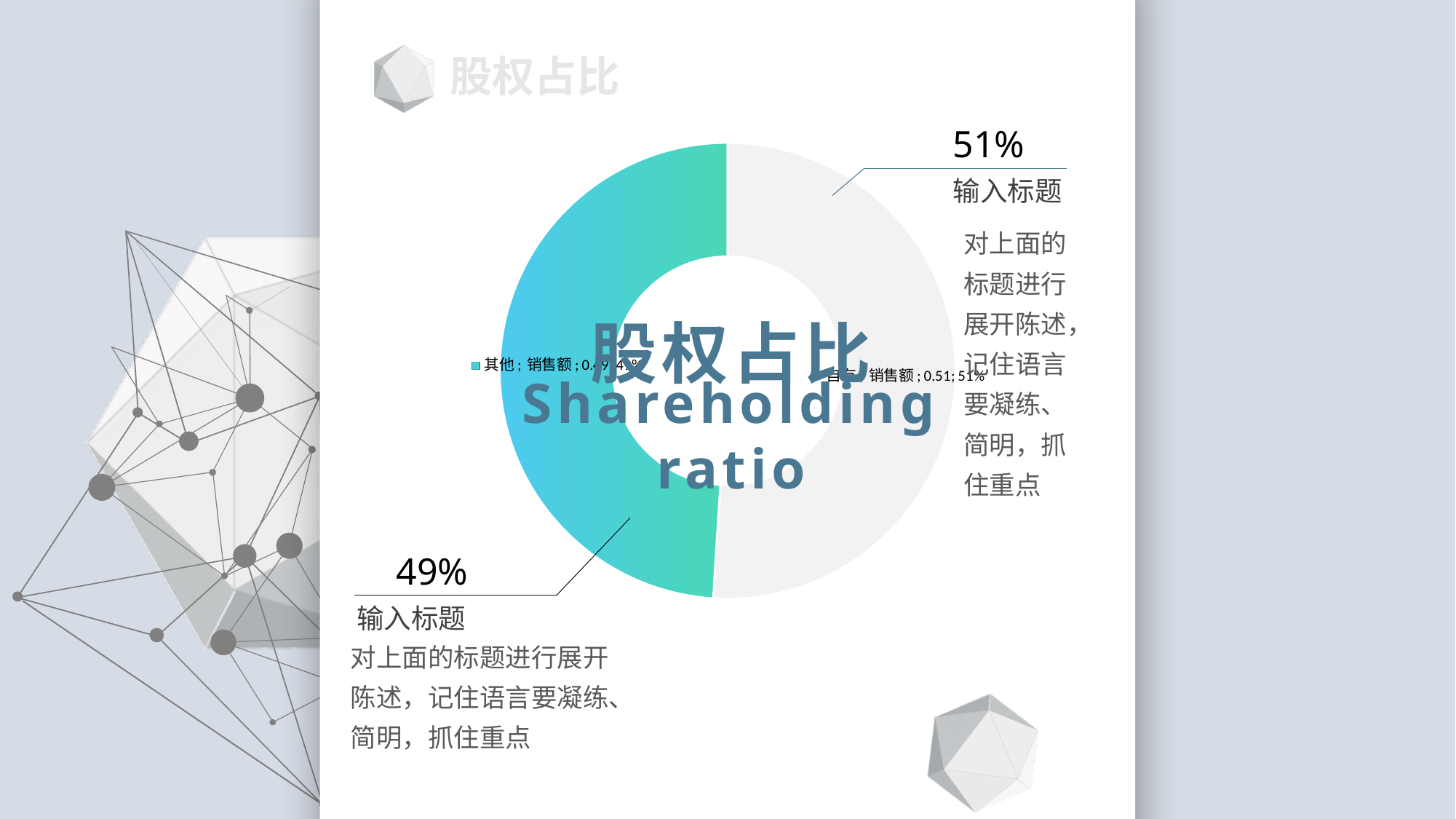
What is the Chinese title of the slide shown at the top left? 股权占比 What percentage is shown for the teal slice on the left of the donut chart? 49% Which slice is larger, the grey slice (51%) or the teal slice (49%)? The grey slice (51%) Which slice of the donut chart is the smallest? The teal slice at 49% What is the English title printed in the centre of the donut chart? Shareholding ratio How many slices does the donut chart have? 2 What share of the donut chart does the slice labelled 其他 represent? 49% Which slice of the donut chart is the largest? The grey slice at 51% What kind of chart is shown on the slide? Pie chart (donut) What is the difference in percentage points between the 51% slice and the 49% slice? 2 percentage points What is the total of the two slices shown in the donut chart? 100% What percentage is shown for the grey slice on the right of the donut chart? 51%